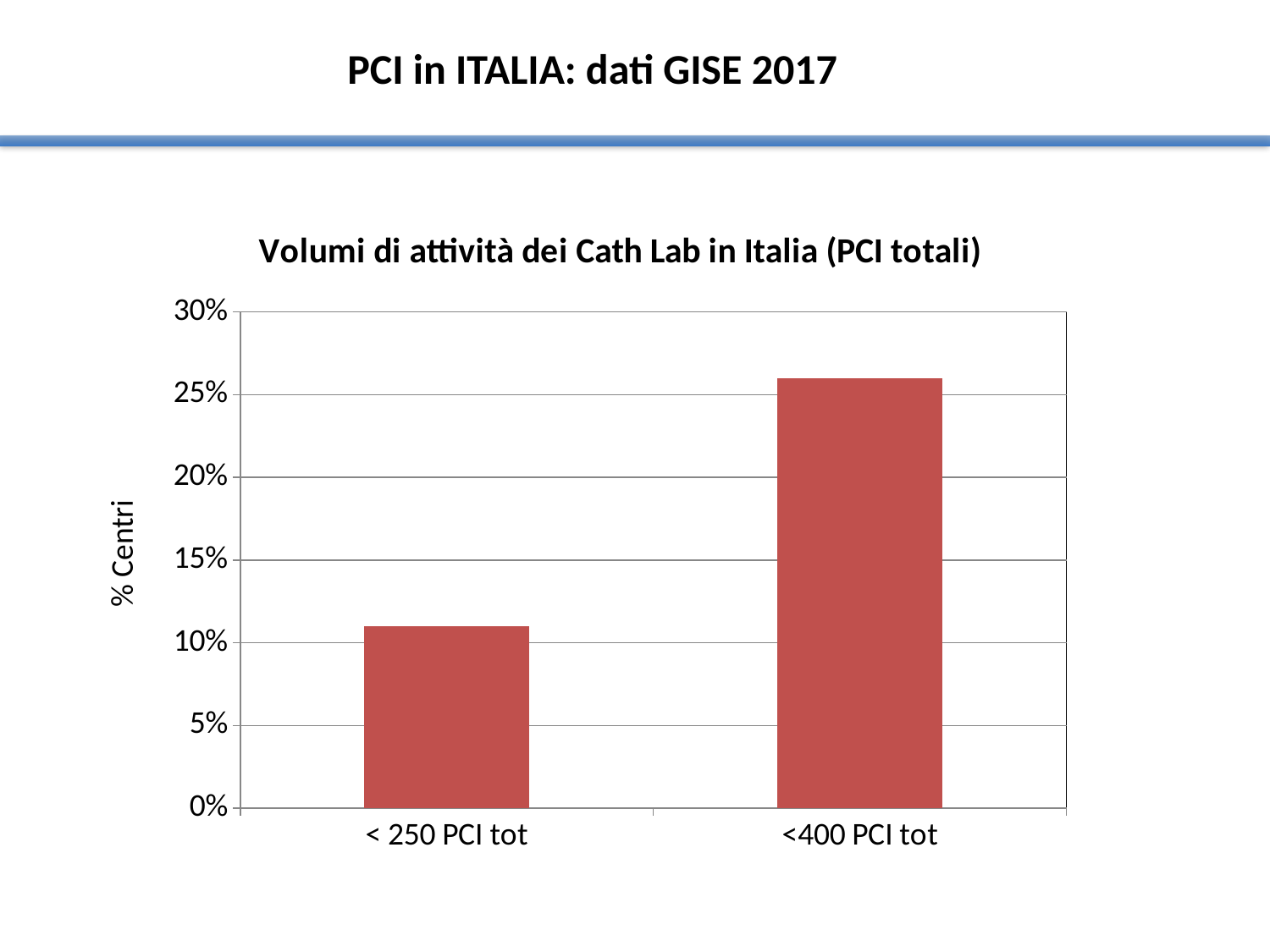
Which category has the lowest value? < 250 PCI tot What is the title of the chart? Volumi di attività dei Cath Lab in Italia (PCI totali) What is the label of the vertical axis? % Centri Which is larger, the value for < 250 PCI tot or the value for <400 PCI tot? <400 PCI tot How many categories are plotted in the chart? 2 Is the value for <400 PCI tot greater or less than 30%? less Is the value for < 250 PCI tot greater or less than 15%? less Is the value for <400 PCI tot greater or less than 25%? greater Which category has the highest value? <400 PCI tot What kind of chart is shown on the slide? bar chart